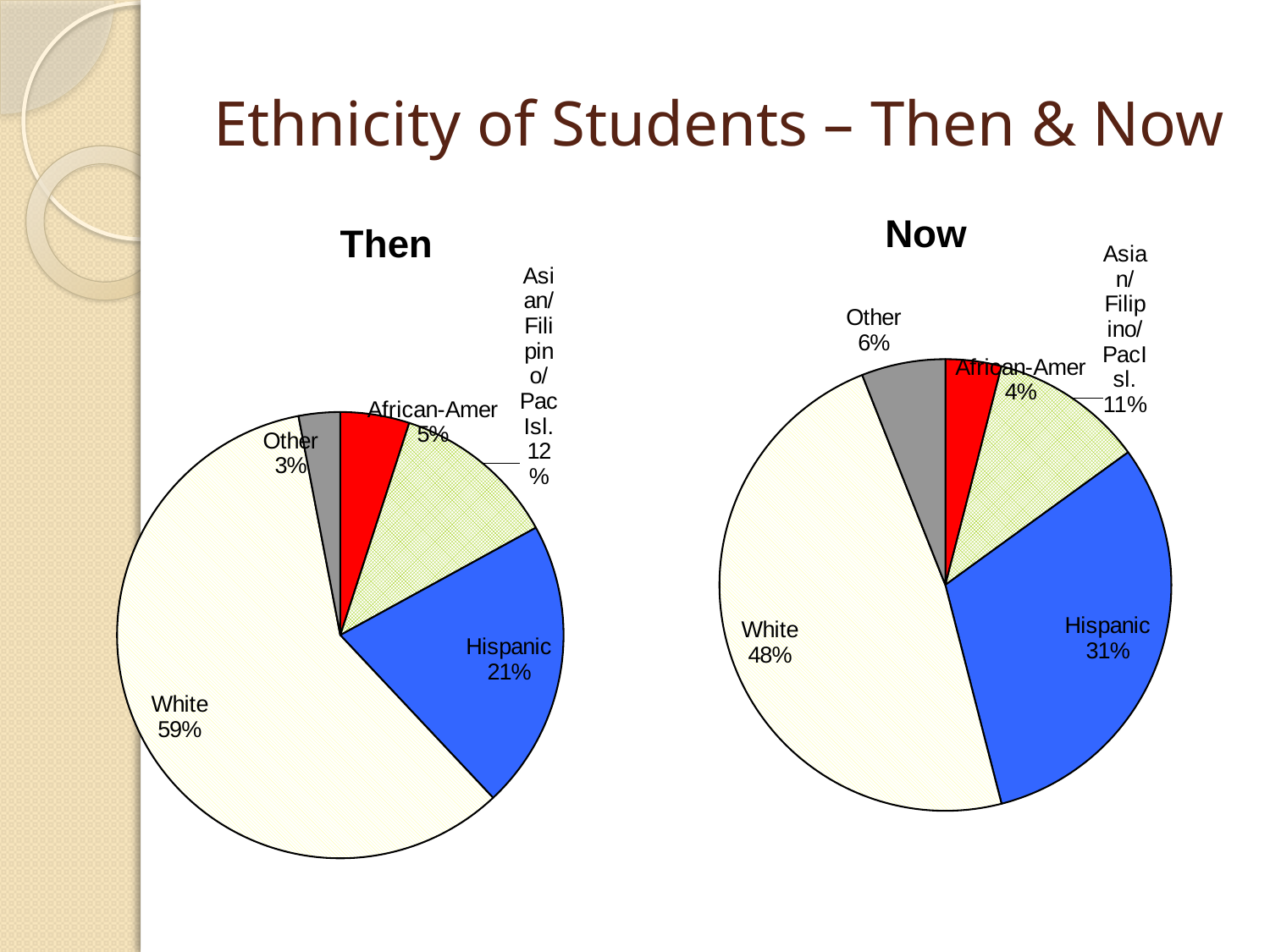
In the "Then" pie chart, which category has the largest slice? White In the "Now" pie chart, which category has the smallest slice? African-Amer In the "Then" pie chart, what share of students is White? 59% What is the difference between the White share in the "Then" chart and the White share in the "Now" chart? 11% In the "Then" pie chart, what percentage is labelled Other? 3% How many slices does the "Now" pie chart have? 5 In the "Then" pie chart, which category has the smallest slice? Other What is the title of the slide containing the two charts? Ethnicity of Students – Then & Now What type of chart is used for the "Then" data? Pie chart Is the Hispanic share larger in the "Then" chart or the "Now" chart? Now In the "Now" pie chart, what percentage is labelled African-Amer? 4% In the "Now" pie chart, what share of students is Hispanic? 31%